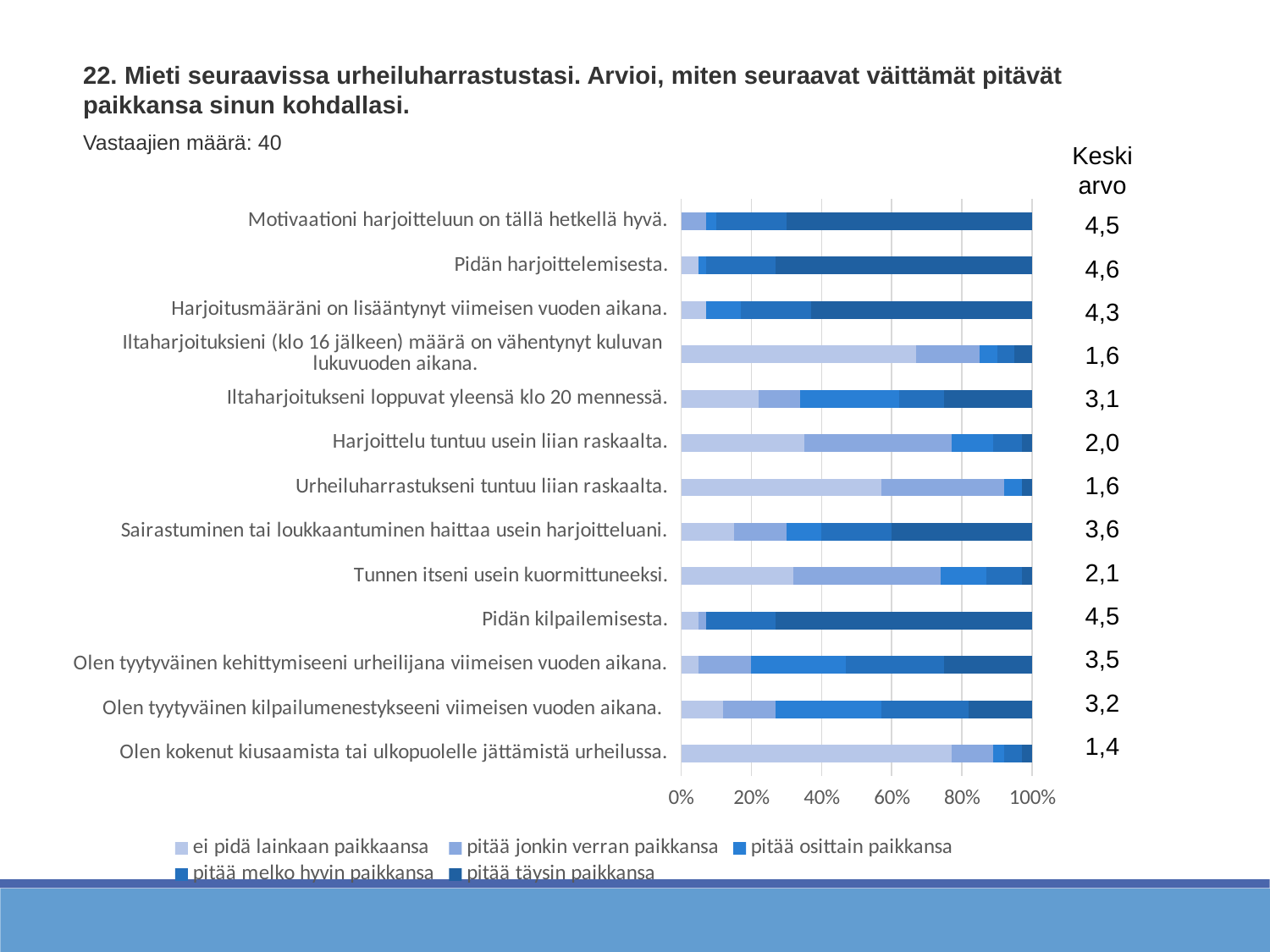
Which statement has the lowest Keskiarvo (mean) value? Olen kokenut kiusaamista tai ulkopuolelle jättämistä urheilussa. How many series does the chart legend list? 5 How many respondents (Vastaajien määrä) does the slide report? 40 Which statement has the highest Keskiarvo (mean) value? Pidän harjoittelemisesta. What kind of chart is shown on the slide? bar chart What is the difference between the highest Keskiarvo value (4,6) and the lowest Keskiarvo value (1,4)? 3,2 What is the Keskiarvo (mean) value shown for "Pidän harjoittelemisesta."? 4,6 Is the "ei pidä lainkaan paikkaansa" share for "Iltaharjoituksieni (klo 16 jälkeen) määrä on vähentynyt kuluvan lukuvuoden aikana." greater or less than 60%? greater Which has the larger Keskiarvo value: "Iltaharjoitukseni loppuvat yleensä klo 20 mennessä." or "Olen tyytyväinen kilpailumenestykseeni viimeisen vuoden aikana."? Olen tyytyväinen kilpailumenestykseeni viimeisen vuoden aikana. What is the Keskiarvo (mean) value shown for "Olen kokenut kiusaamista tai ulkopuolelle jättämistä urheilussa."? 1,4 How many statements (categories) are plotted in the chart? 13